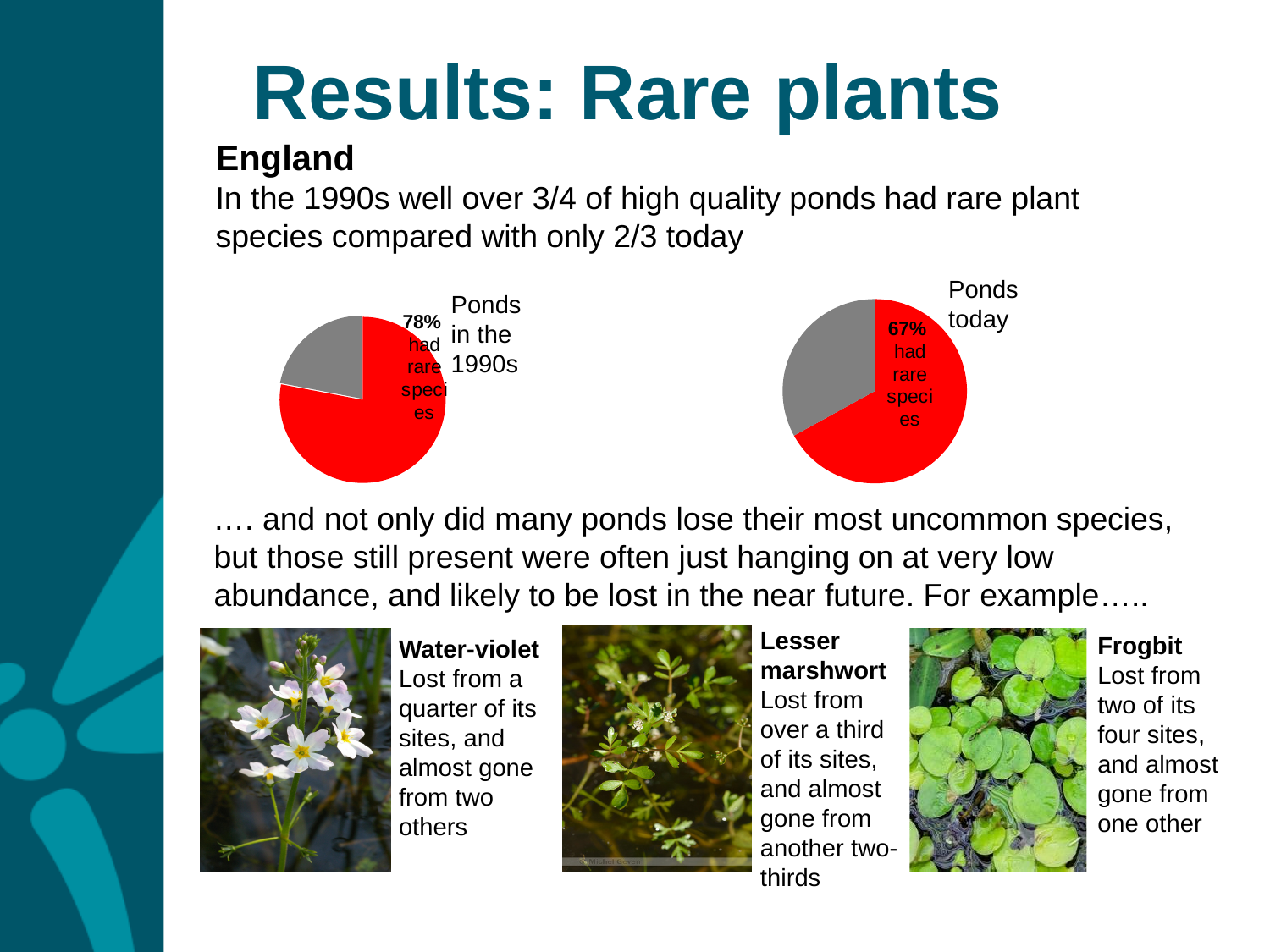
How many pie charts are shown on the slide? 2 What type of chart is the 'Ponds today' chart? Pie chart By how many percentage points did the share of ponds with rare species fall between the 'Ponds in the 1990s' chart and the 'Ponds today' chart? 11 percentage points How many slices does the 'Ponds today' pie chart have? 2 In the 'Ponds today' pie chart, what percentage of ponds had rare species? 67% In the 'Ponds in the 1990s' pie chart, what colour is the slice representing ponds that had rare species? Red What type of chart is used to show the share of ponds with rare species in the 1990s? Pie chart Which pie chart shows a larger share of ponds with rare species, 'Ponds in the 1990s' or 'Ponds today'? Ponds in the 1990s How many slices does the 'Ponds in the 1990s' pie chart have? 2 In the 'Ponds in the 1990s' pie chart, what percentage of ponds had rare species? 78% In the 'Ponds today' pie chart, is the share of ponds that had rare species greater or less than 50%? greater